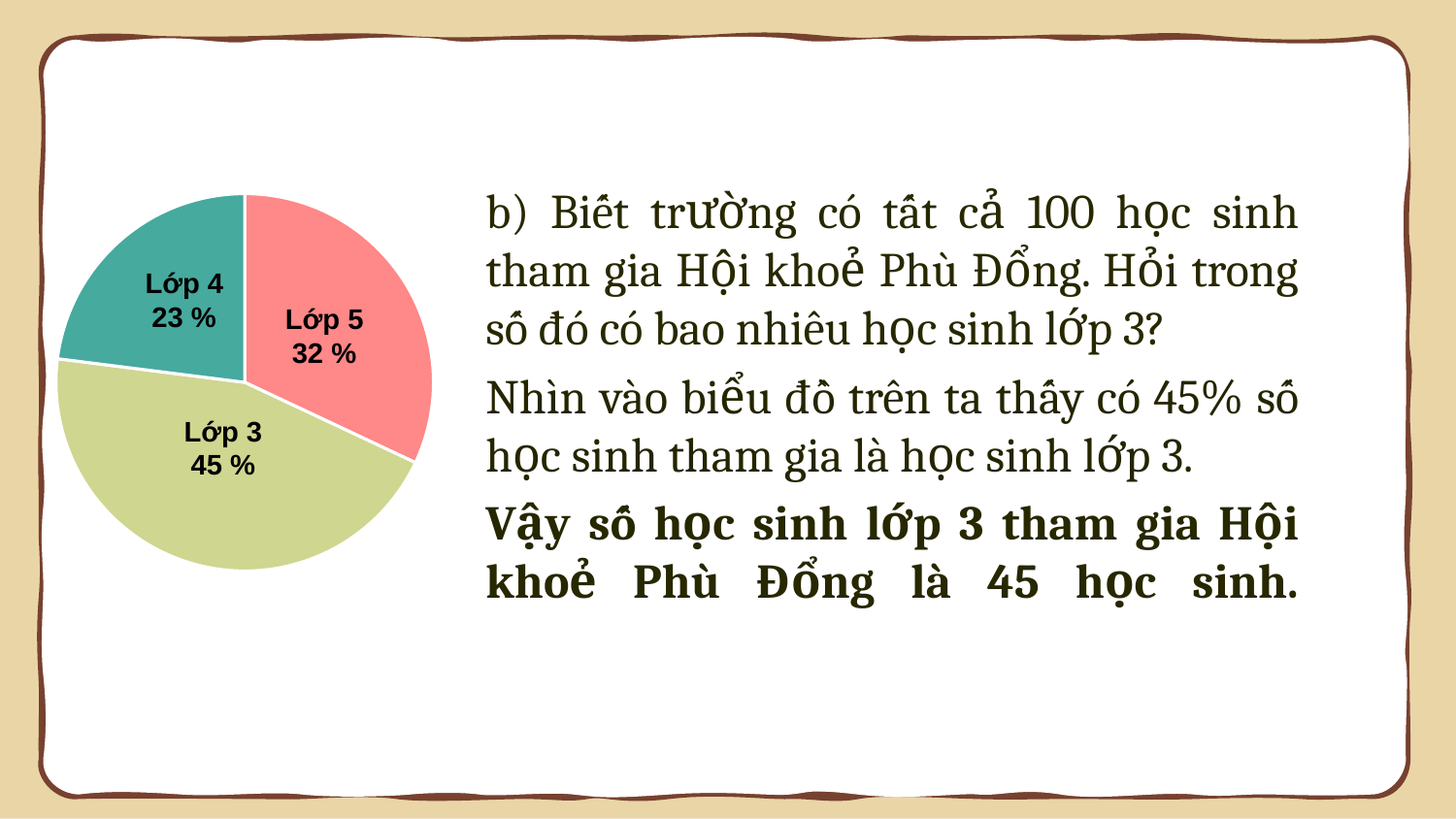
Which class has the largest slice of the pie? Lớp 3 What is the value for Lớp 4? 23 % Which class has the smallest slice of the pie? Lớp 4 What is the difference between the values for Lớp 3 and Lớp 5? 13 % What is the value for Lớp 5? 32 % What is the difference between the values for Lớp 5 and Lớp 4? 9 % What share of the pie does Lớp 3 represent? 45 % Which is larger, the value for Lớp 4 or the value for Lớp 5? Lớp 5 What kind of chart is shown on the slide? pie chart How many slices does the pie chart have? 3 What is the value for Lớp 3? 45 % What colour is the slice for Lớp 4? teal